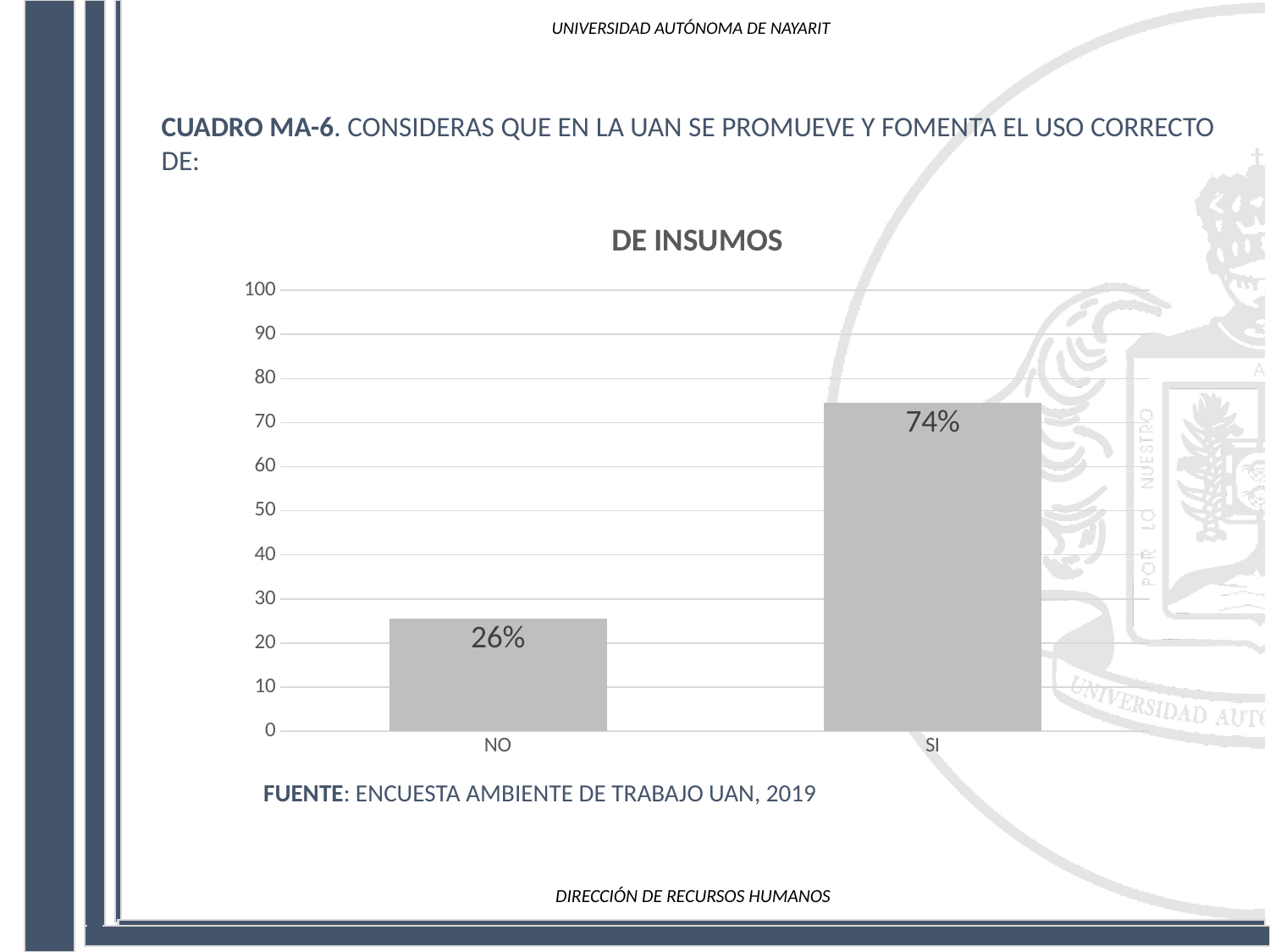
What is the maximum value shown on the vertical axis? 100 What is the value for NO? 26% What is the title of the chart? DE INSUMOS How many categories are shown on the x axis? 2 Which is larger, the value for NO or the value for SI? SI Is the value for NO greater or less than 30? less What kind of chart is shown on the slide? bar chart What is the difference between the values for SI and NO? 48% Is the value for SI greater or less than 70? greater Which category has the lowest value? NO Which category has the highest value? SI What is the value for SI? 74%